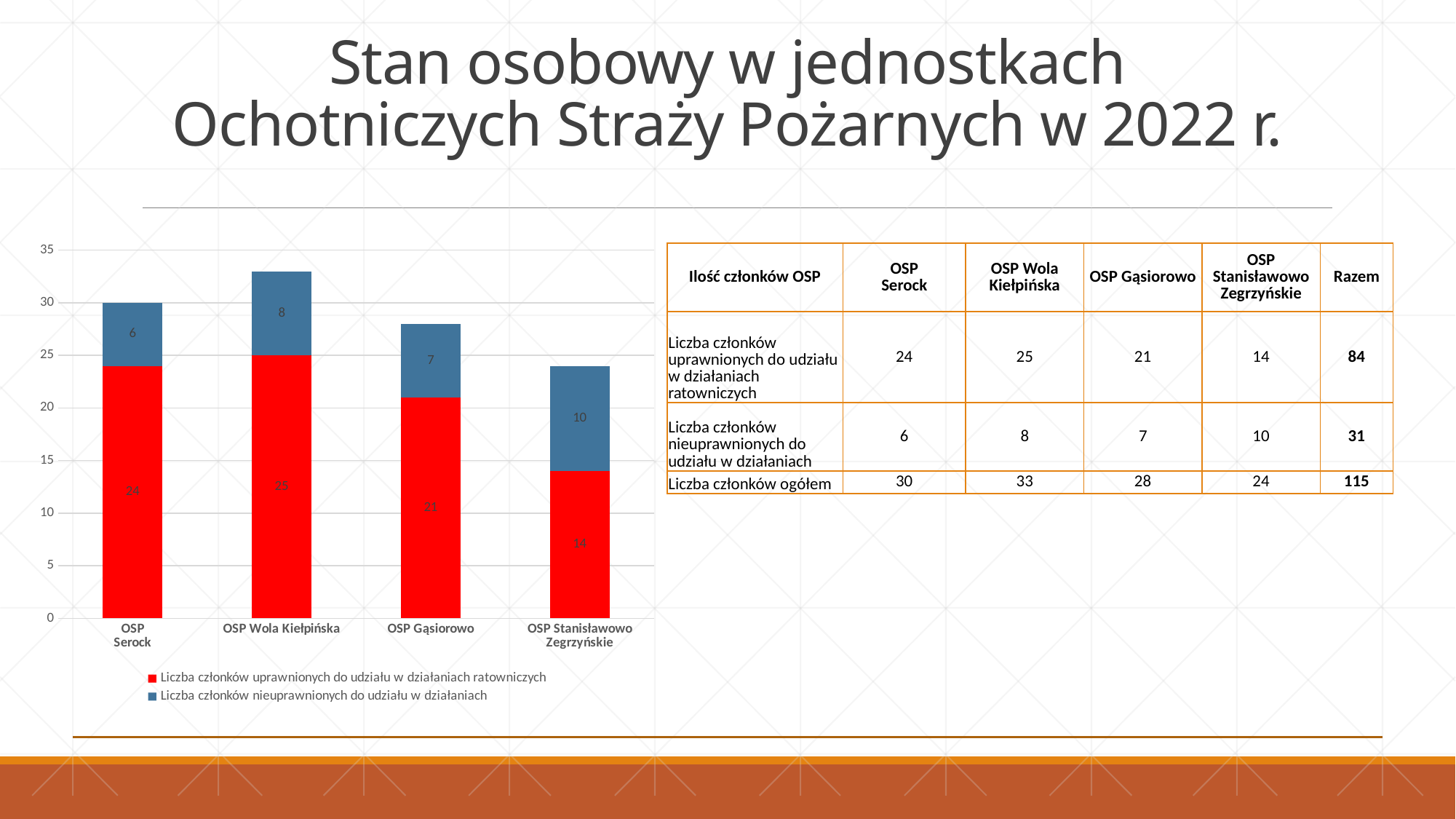
What is the difference between the 'Liczba członków uprawnionych' values for OSP Serock and OSP Gąsiorowo? 3 Which unit has the lowest value for 'Liczba członków uprawnionych do udziału w działaniach ratowniczych'? OSP Stanisławowo Zegrzyńskie What is the value of 'Liczba członków uprawnionych do udziału w działaniach ratowniczych' for OSP Wola Kiełpińska? 25 Which is larger: the 'Liczba członków nieuprawnionych' value for OSP Wola Kiełpińska or for OSP Gąsiorowo? OSP Wola Kiełpińska Which unit has the highest value for 'Liczba członków uprawnionych do udziału w działaniach ratowniczych'? OSP Wola Kiełpińska What is the value of 'Liczba członków nieuprawnionych do udziału w działaniach' for OSP Stanisławowo Zegrzyńskie? 10 How many units (categories) are shown on the x axis of the chart? 4 What is the total height of the stacked bar for OSP Wola Kiełpińska? 33 How many series does the chart legend list? 2 What is the value of 'Liczba członków nieuprawnionych do udziału w działaniach' for OSP Serock? 6 What type of chart is shown on the slide? Stacked bar chart What is the total height of the stacked bar for OSP Gąsiorowo? 28